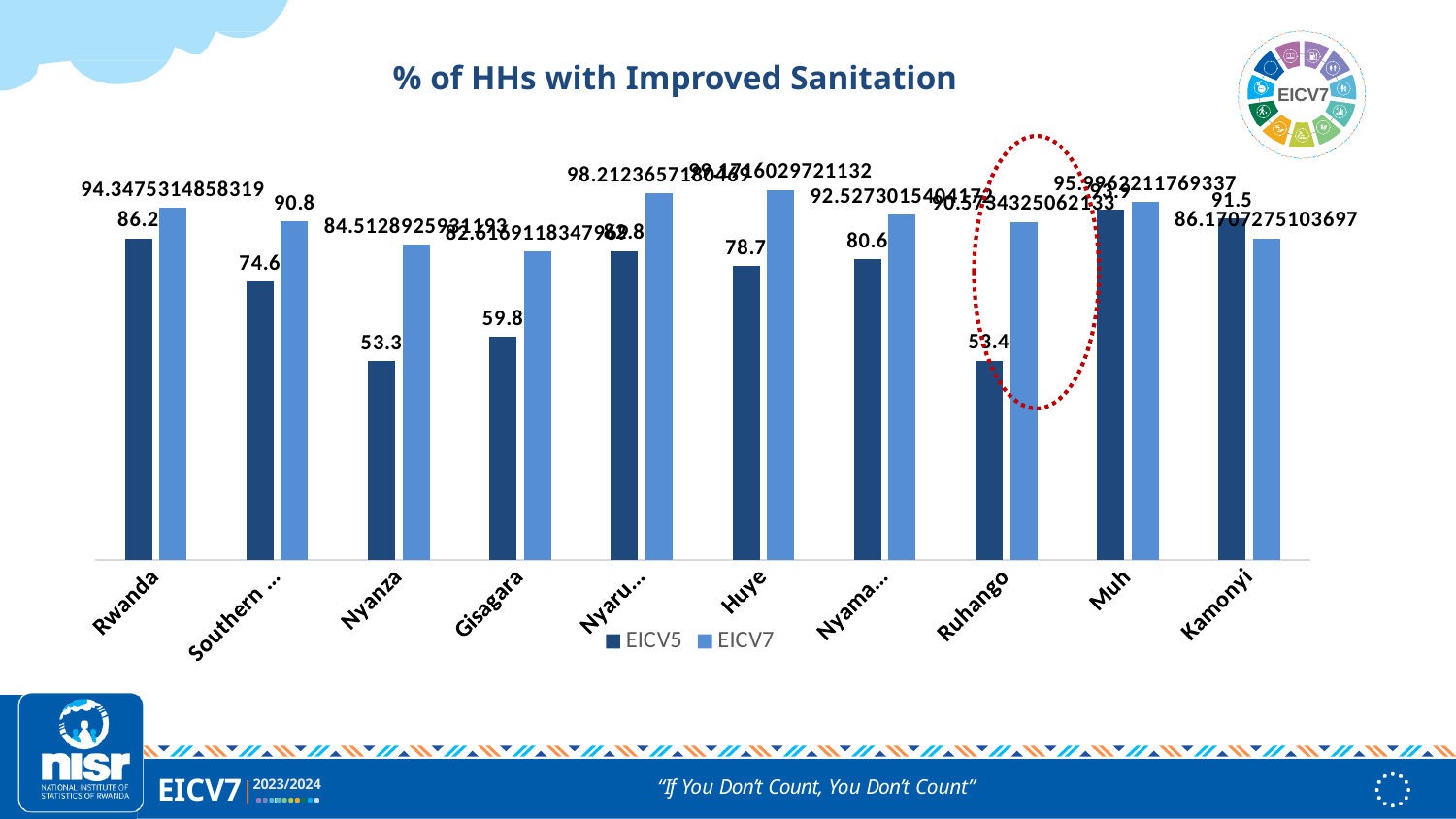
How many series does the legend list? 2 What is the EICV5 value for Huye? 78.7 For Kamonyi, which series has the larger value, EICV5 or EICV7? EICV5 What is the EICV5 value for Kamonyi? 91.5 What is the EICV7 value for Southern? 90.8 What is the EICV5 value for Rwanda? 86.2 What is the title of the chart? % of HHs with Improved Sanitation How many categories are shown on the x axis? 10 What kind of chart is shown on the slide? bar chart For Rwanda, which series has the larger value, EICV5 or EICV7? EICV7 What is the EICV5 value for Ruhango? 53.4 What is the difference between the EICV7 and EICV5 values for Southern? 16.2